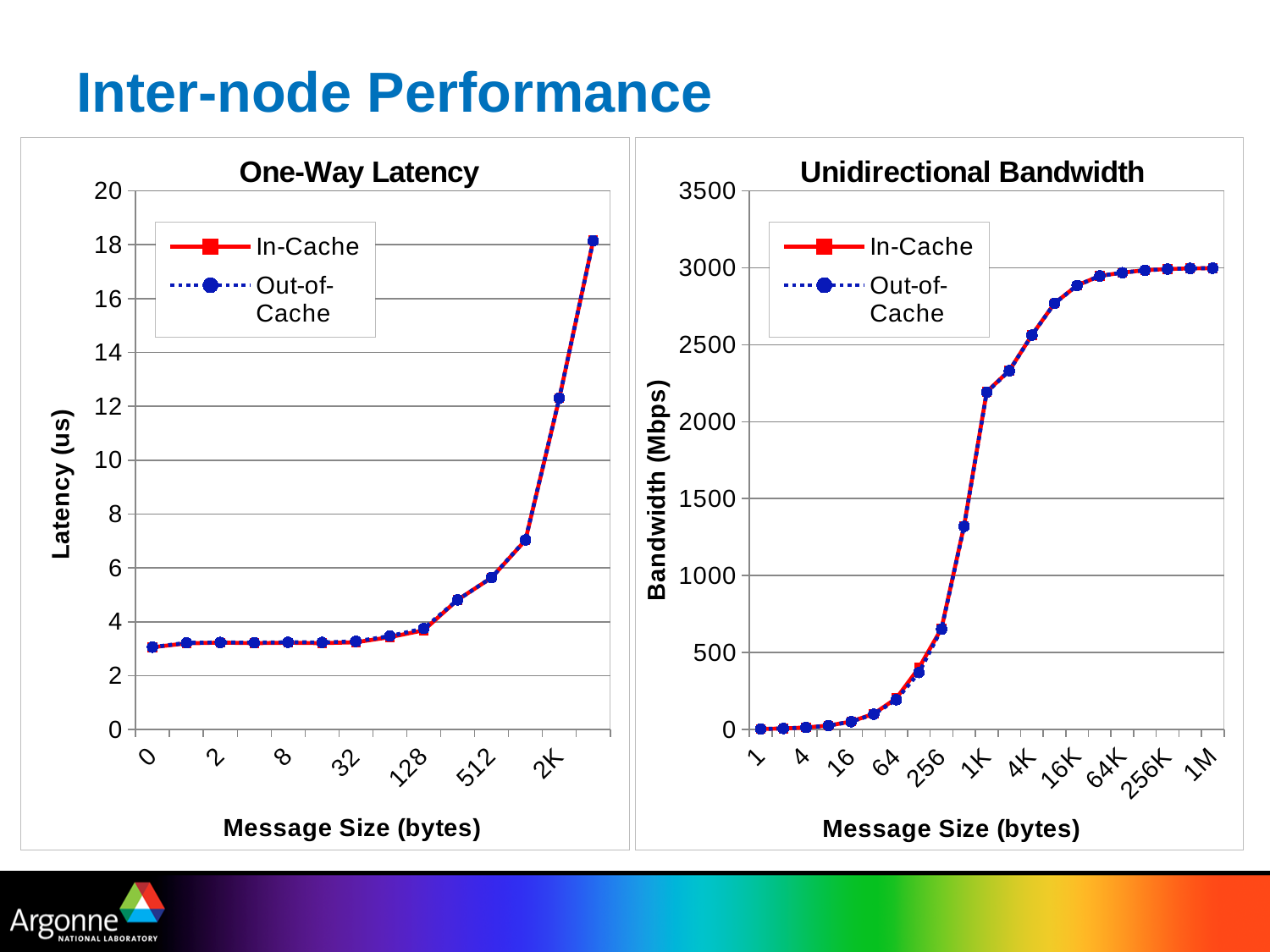
In the One-Way Latency chart, is the latency at message size 2K greater or less than 10? greater In the Unidirectional Bandwidth chart, does bandwidth rise or fall as message size increases along the x axis? rise In the One-Way Latency chart, does latency rise or fall as message size increases from 512 to 2K? rise In the One-Way Latency chart, is the latency at message size 128 greater or less than 6? less What kind of chart is the One-Way Latency chart? line chart In the Unidirectional Bandwidth chart, is the bandwidth at message size 64 greater or less than 500? less In the One-Way Latency chart, what are the two series named in the legend? In-Cache and Out-of-Cache How many message-size labels are shown on the x axis of the Unidirectional Bandwidth chart? 11 How many series does the legend of the Unidirectional Bandwidth chart list? 2